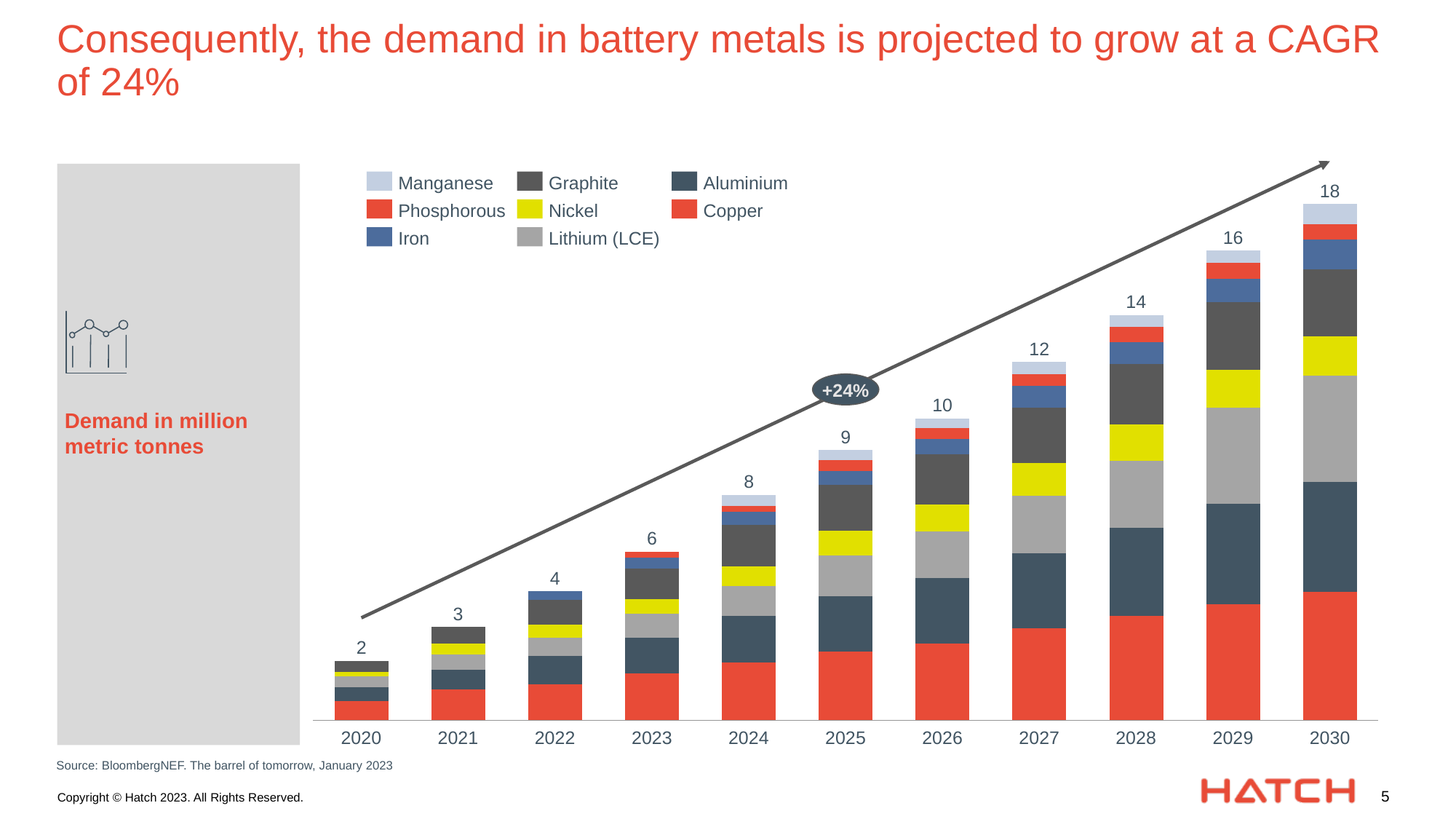
How many years are shown on the x axis? 11 What is the difference between the total demand in 2028 and in 2024? 6 How many series does the legend list? 8 Which year has the highest total demand? 2030 What is the total demand shown for 2020? 2 What kind of chart is shown on the slide? Stacked bar chart What is the difference between the total demand in 2030 and in 2020? 16 Do the total demand values rise or fall from 2020 to 2030? Rise What is the total demand shown for 2025? 9 What is the total demand shown for 2030? 18 Which year has the lowest total demand? 2020 Which year has a larger total demand, 2023 or 2026? 2026